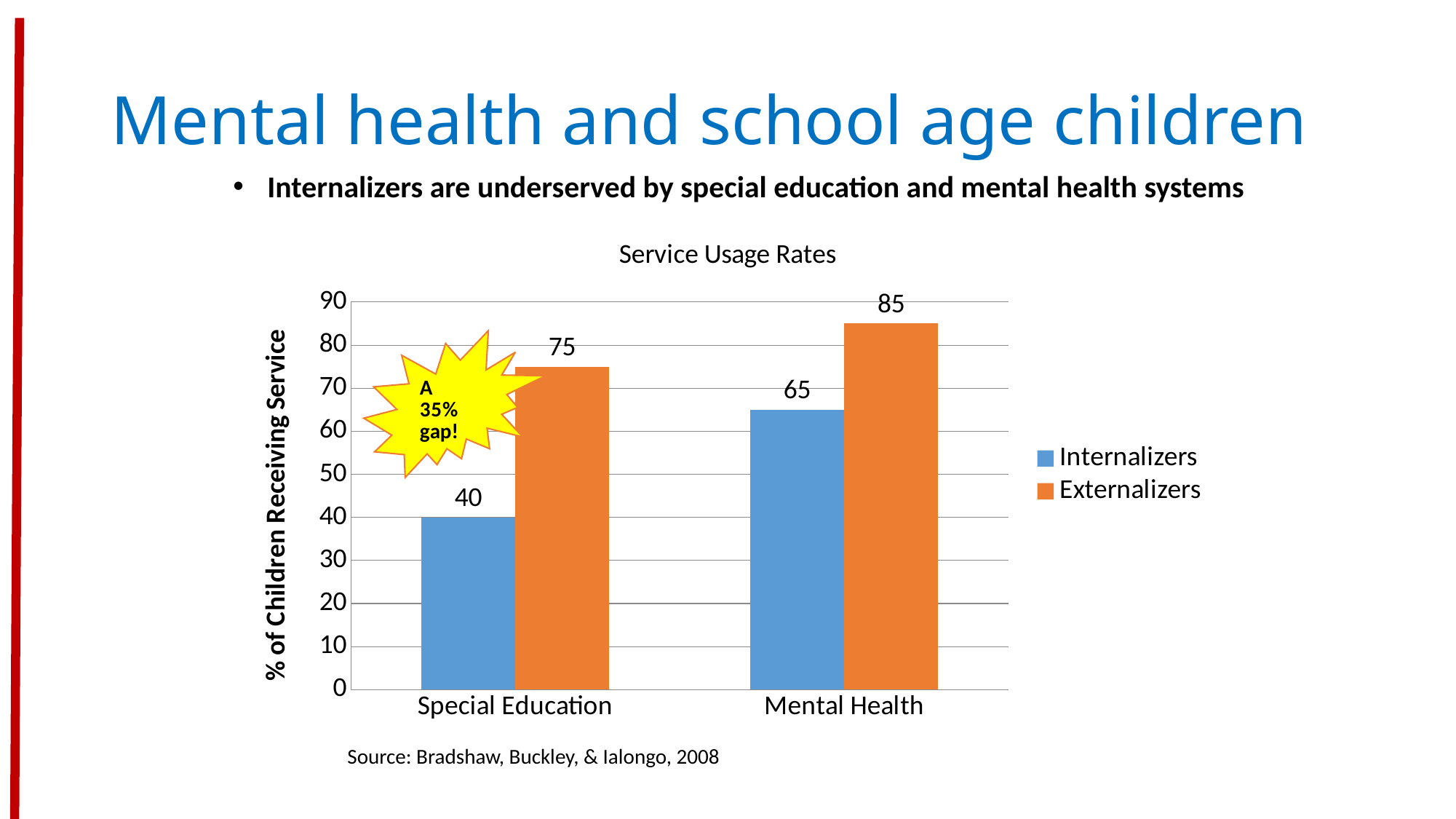
Which bar has the highest value on the chart? Externalizers, Mental Health What type of chart is shown? Bar chart What is the difference between Externalizers and Internalizers in Mental Health? 20 What is the value for Internalizers in Special Education? 40 What is the value for Externalizers in Mental Health? 85 What is the value for Internalizers in Mental Health? 65 What is the value for Externalizers in Special Education? 75 How many categories are shown on the x axis? 2 How many series does the legend list? 2 What is the difference between Externalizers and Internalizers in Special Education? 35 Which is larger: Internalizers in Mental Health or Externalizers in Special Education? Externalizers in Special Education Which bar has the lowest value on the chart? Internalizers, Special Education